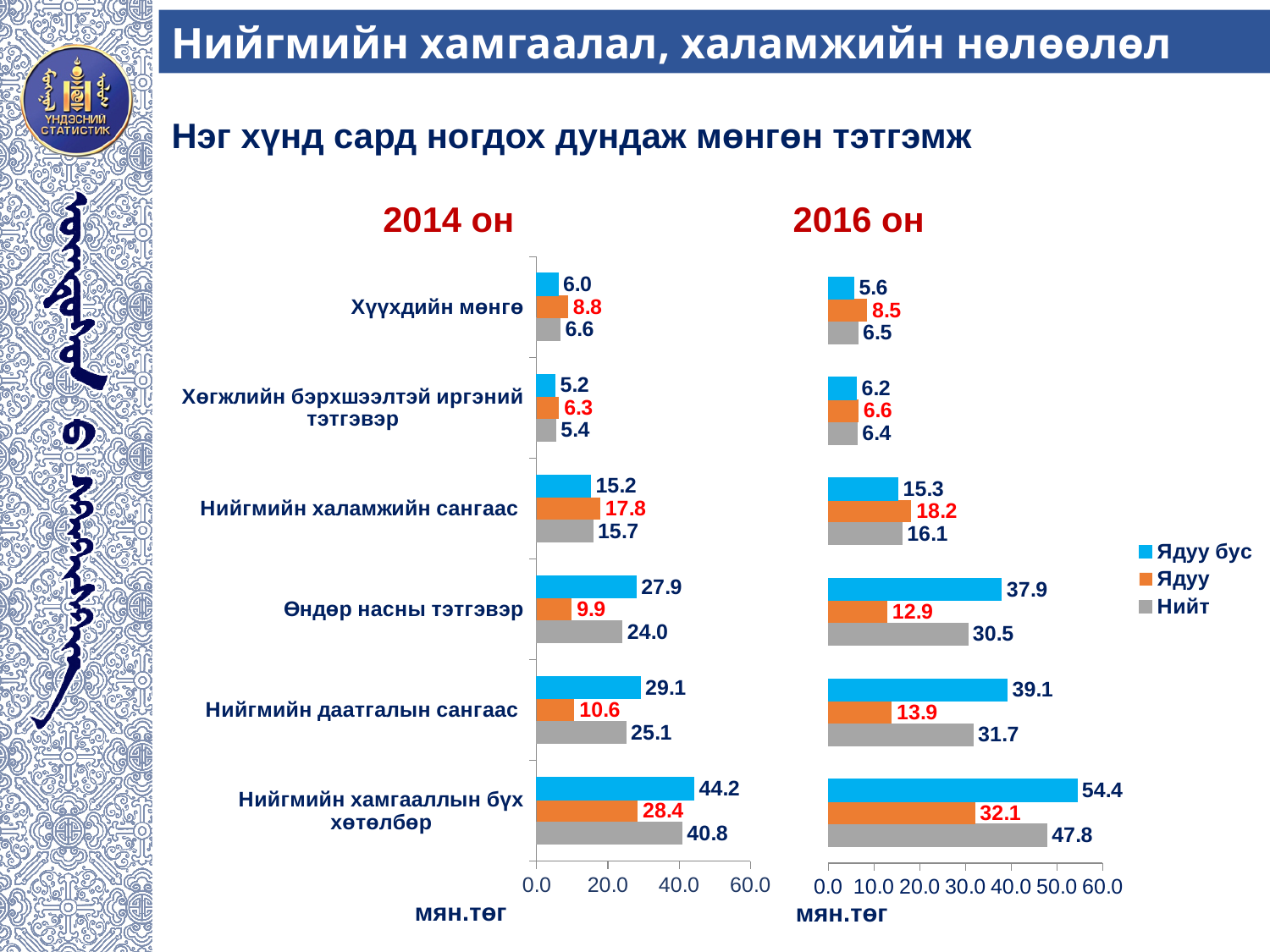
In the 2016 он chart, is the Нийт value for Нийгмийн даатгалын сангаас greater or less than 30.0? greater In the 2016 он chart, what is the Нийт value for Хүүхдийн мөнгө? 6.5 Which colour represents the Ядуу series in the charts? orange In the 2016 он chart, what is the value of Ядуу for Өндөр насны тэтгэвэр? 12.9 What is the difference between the Ядуу бус values for Нийгмийн хамгааллын бүх хөтөлбөр in the 2016 он chart and the 2014 он chart? 10.2 What type of chart is the 2016 он chart? bar chart How many categories are shown in the 2014 он chart? 6 In the 2014 он chart, which category has the highest Нийт value? Нийгмийн хамгааллын бүх хөтөлбөр In the 2014 он chart, which is larger for Өндөр насны тэтгэвэр: Ядуу бус or Ядуу? Ядуу бус How many series does the legend list for the charts? 3 In the 2016 он chart, which category has the lowest Ядуу бус value? Хүүхдийн мөнгө In the 2014 он chart, what is the value of Ядуу бус for Нийгмийн хамгааллын бүх хөтөлбөр? 44.2